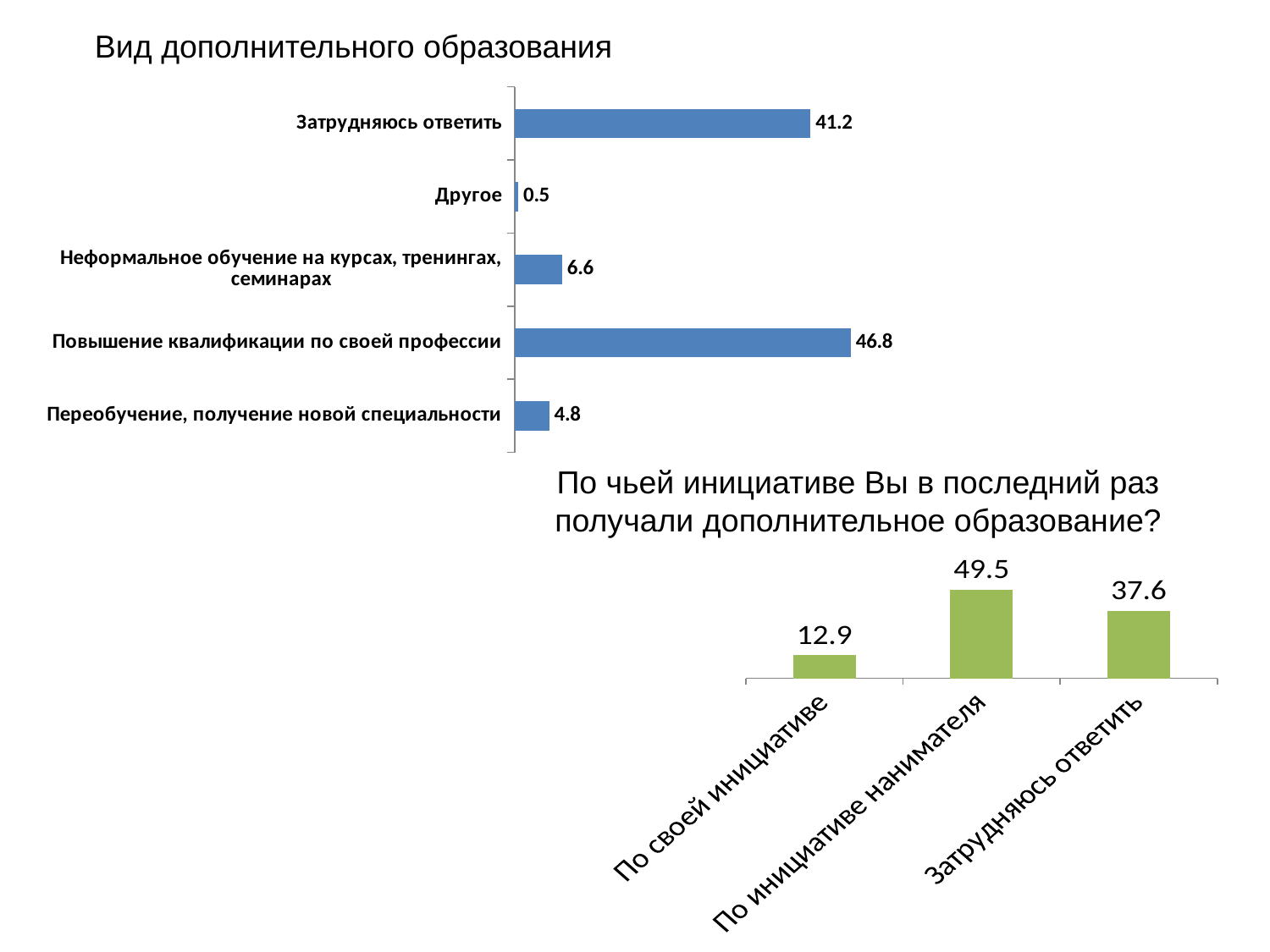
In the chart 'Вид дополнительного образования', how many categories are shown? 5 In the chart 'Вид дополнительного образования', what is the value for 'Другое'? 0.5 In the chart 'Вид дополнительного образования', which category has the lowest value? Другое In the chart 'Вид дополнительного образования', what is the value for 'Повышение квалификации по своей профессии'? 46.8 In the chart 'Вид дополнительного образования', what is the difference between 'Повышение квалификации по своей профессии' and 'Затрудняюсь ответить'? 5.6 What type of chart is the chart 'По чьей инициативе Вы в последний раз получали дополнительное образование?'? Bar chart In the chart 'По чьей инициативе Вы в последний раз получали дополнительное образование?', which category has the lowest value? По своей инициативе In the chart 'По чьей инициативе Вы в последний раз получали дополнительное образование?', what is the difference between 'По инициативе нанимателя' and 'Затрудняюсь ответить'? 11.9 In the chart 'Вид дополнительного образования', which category has the highest value? Повышение квалификации по своей профессии In the chart 'По чьей инициативе Вы в последний раз получали дополнительное образование?', how many categories are shown? 3 In the chart 'По чьей инициативе Вы в последний раз получали дополнительное образование?', what is the value for 'По инициативе нанимателя'? 49.5 In the chart 'Вид дополнительного образования', which is larger: 'Неформальное обучение на курсах, тренингах, семинарах' or 'Переобучение, получение новой специальности'? Неформальное обучение на курсах, тренингах, семинарах